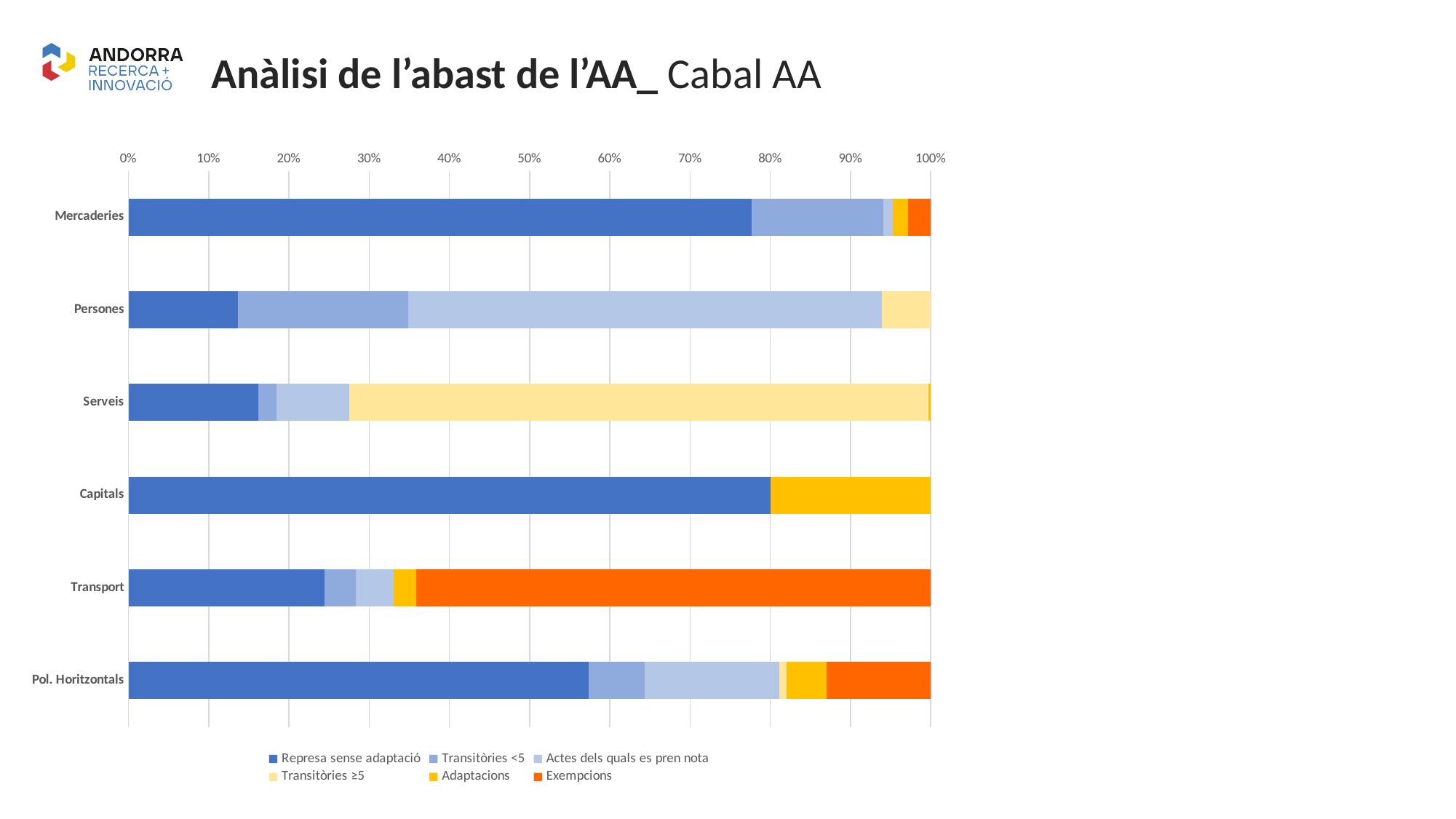
Which category has the largest 'Exempcions' share? Transport Which category has the largest 'Transitòries ≥5' share? Serveis Which category has the largest 'Actes dels quals es pren nota' share? Persones What is the first series listed in the chart legend? Represa sense adaptació What kind of chart is shown on the slide? Stacked bar chart Is the 'Represa sense adaptació' share for Pol. Horitzontals greater or less than 50%? greater How many categories are shown on the vertical axis of the chart? 6 Is the 'Represa sense adaptació' share for Capitals greater or less than 70%? greater How many series does the chart legend list? 6 Which has a larger 'Represa sense adaptació' share, Mercaderies or Transport? Mercaderies Is the 'Represa sense adaptació' share for Persones greater or less than 20%? less